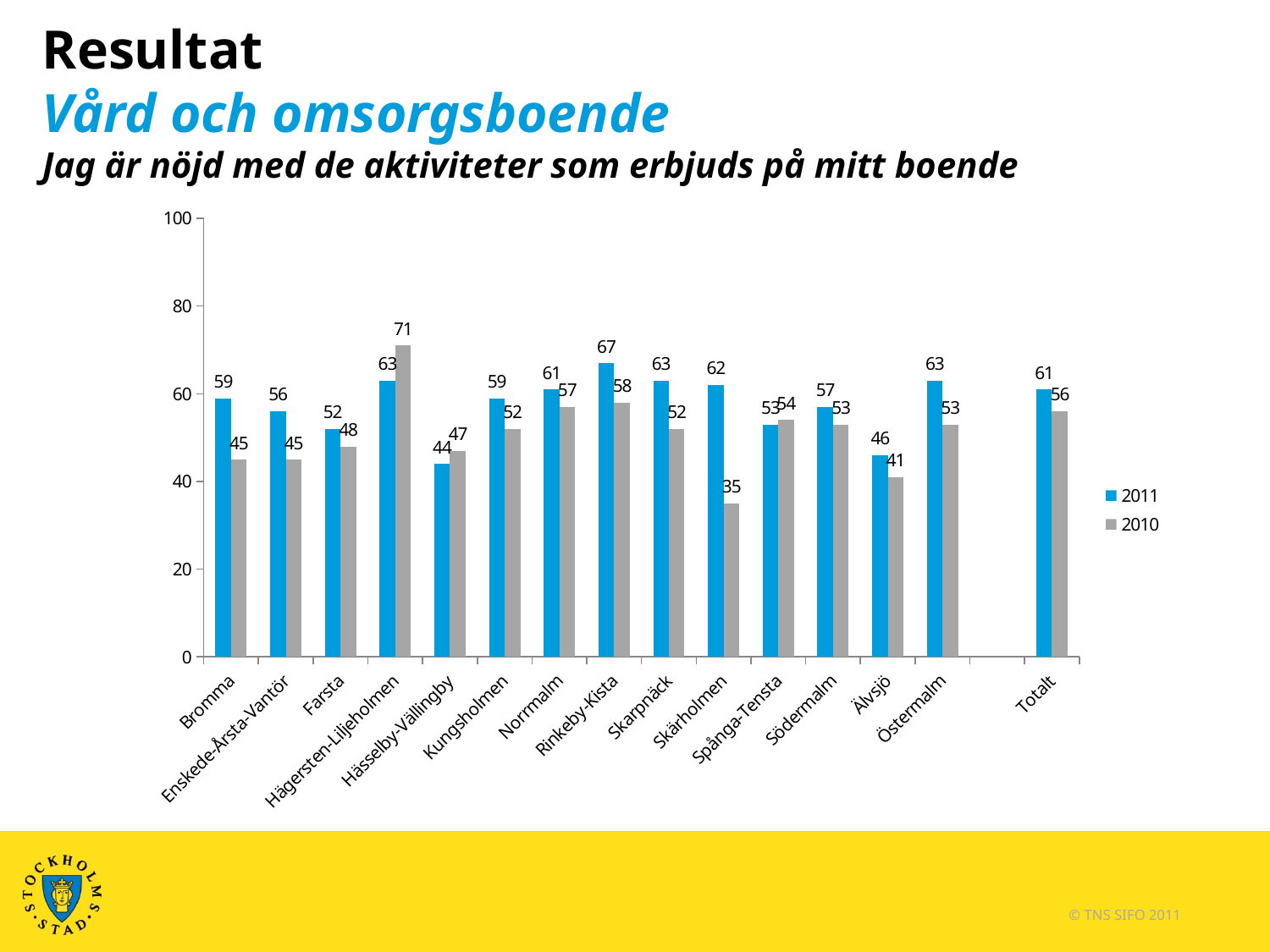
Which category has the highest 2011 value? Rinkeby-Kista What kind of chart is shown on the slide? bar chart What is the 2011 value for Totalt? 61 Which is larger for Hägersten-Liljeholmen, the 2011 value or the 2010 value? 2010 Which category has the lowest 2011 value? Hässelby-Vällingby How many categories are shown on the x axis? 15 How many series does the legend list? 2 What is the 2010 value for Hägersten-Liljeholmen? 71 Is the 2010 value for Bromma greater or less than 60? less What is the 2011 value for Skärholmen? 62 Which category has the lowest 2010 value? Skärholmen What is the difference between the 2011 and 2010 values for Skärholmen? 27